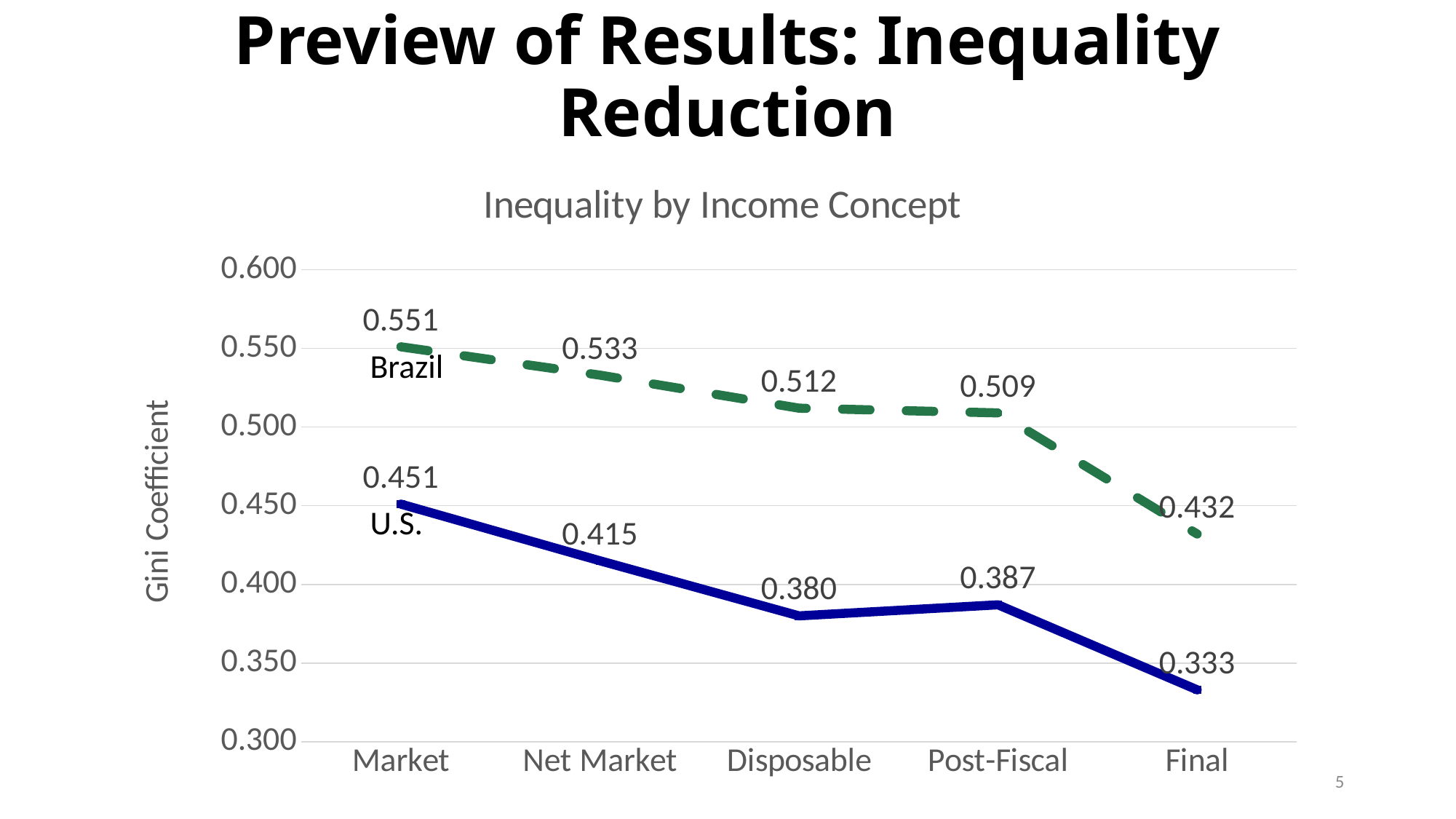
How many income concepts are shown on the x axis? 5 At which income concept is the U.S. Gini coefficient lowest? Final What is the Gini coefficient for the U.S. at Disposable income? 0.380 Which is larger, the U.S. Gini coefficient at Disposable income or at Post-Fiscal income? Post-Fiscal What is the Gini coefficient for Brazil at Final income? 0.432 What is the Gini coefficient for Brazil at Market income? 0.551 What is the difference between the U.S. Gini coefficient at Market income and at Final income? 0.118 What type of chart is shown on the slide? Line chart What is the title of the chart? Inequality by Income Concept What is the Gini coefficient for the U.S. at Post-Fiscal income? 0.387 What is the difference between the Brazil and U.S. Gini coefficients at Market income? 0.100 At which income concept is the Brazil Gini coefficient highest? Market